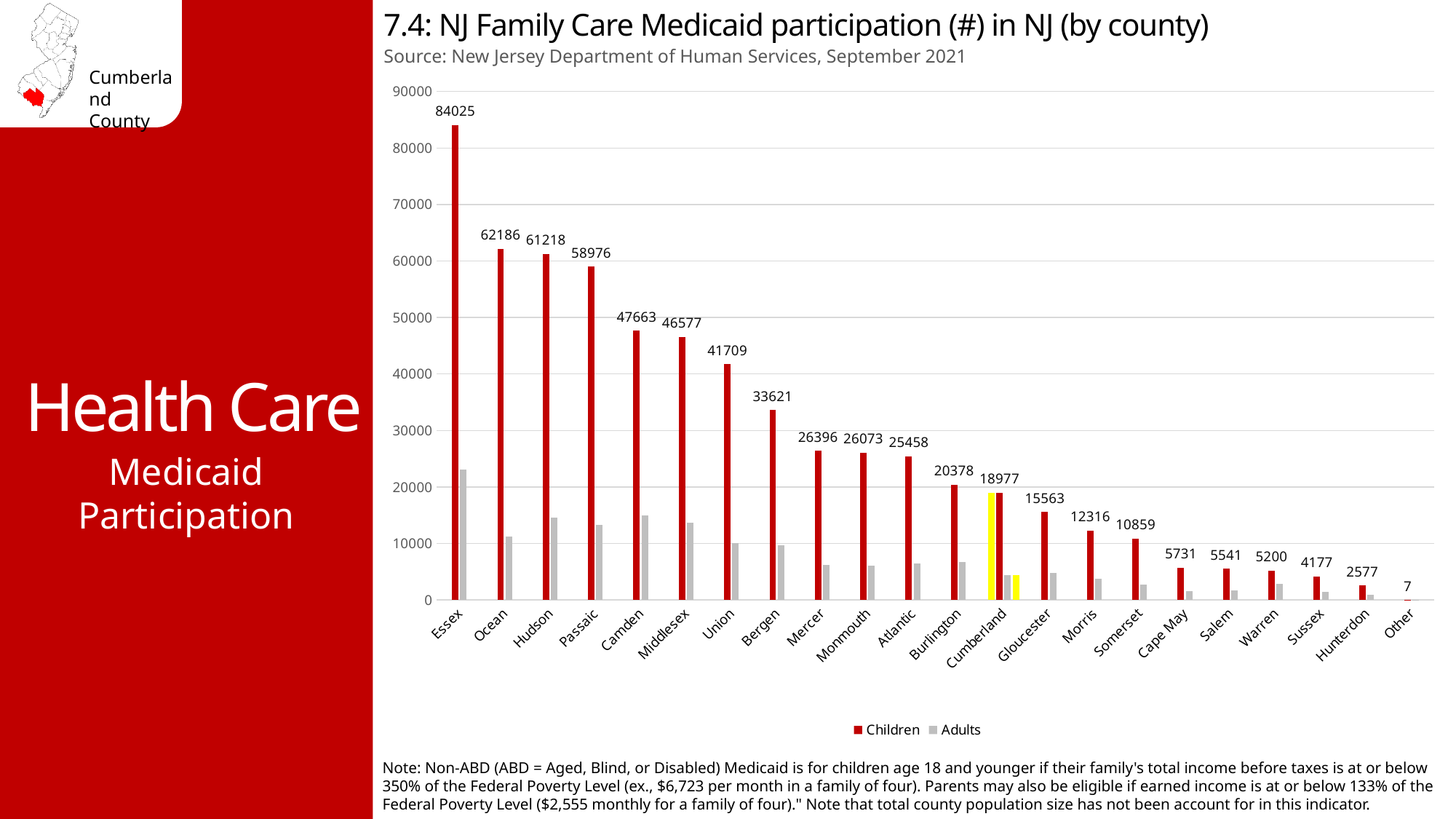
How many categories are shown on the x axis? 22 What is the Children value for Cumberland? 18977 What is the difference between the Children values for Ocean and Hudson? 968 Do the Children values rise or fall moving from left to right along the x axis? fall Is the Adults value for Essex greater or less than 20000? greater What kind of chart is shown on the slide? bar chart What is the Children value for Hunterdon? 2577 Which category has the lowest Children value? Other What is the Children value for Essex? 84025 Which category has the highest Children value? Essex Which has a larger Children value, Camden or Middlesex? Camden How many series does the legend list? 2